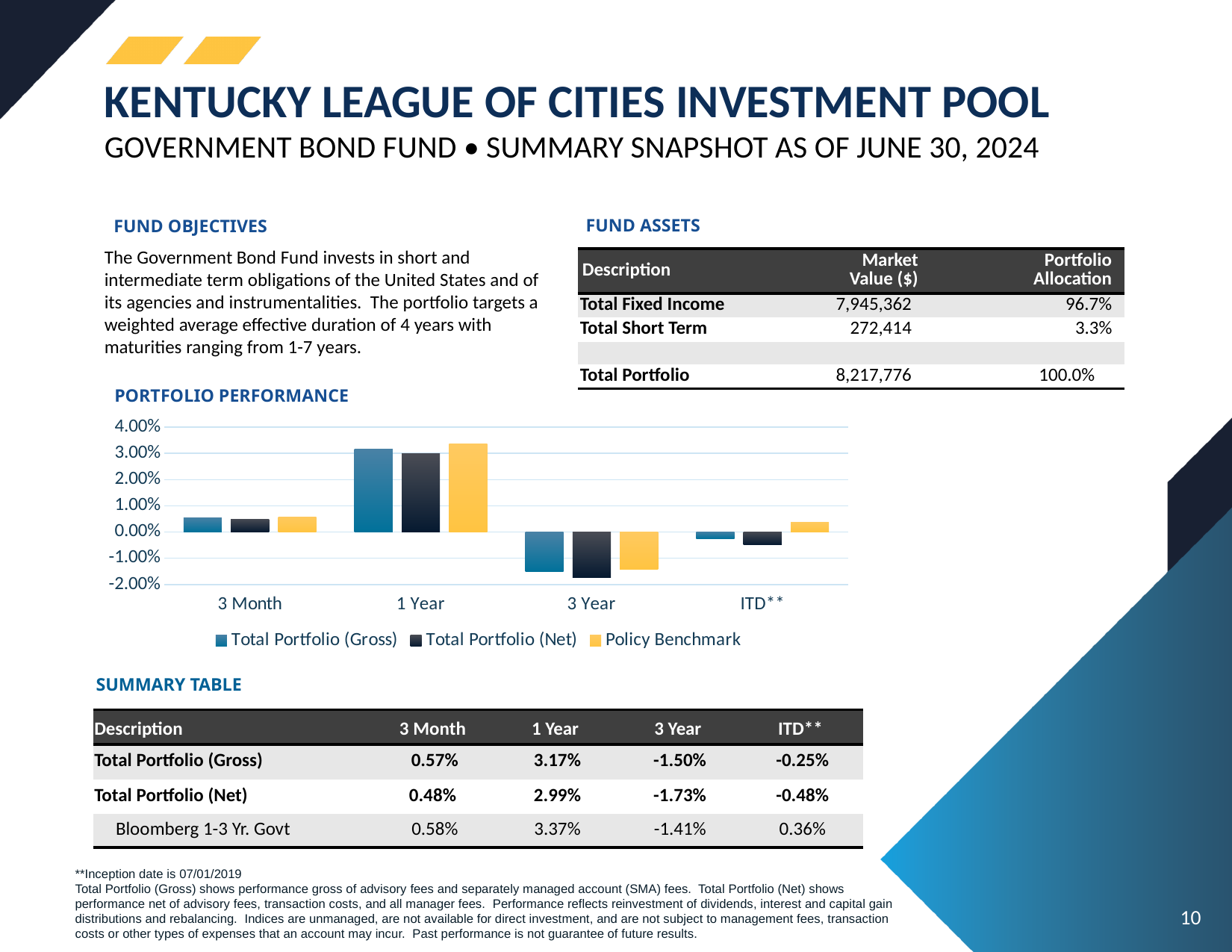
What kind of chart is shown under PORTFOLIO PERFORMANCE? Bar chart In the PORTFOLIO PERFORMANCE chart, which period has the lowest Total Portfolio (Net) value? 3 Year For the 1 Year period, which is larger: Total Portfolio (Gross) or Total Portfolio (Net)? Total Portfolio (Gross) What are the three legend entries of the PORTFOLIO PERFORMANCE chart? Total Portfolio (Gross), Total Portfolio (Net), Policy Benchmark What is the 1 Year value for Total Portfolio (Gross)? 3.17% What is the 3 Year value for Total Portfolio (Net)? -1.73% Is the Policy Benchmark value for 1 Year greater or less than 3.00%? greater Is the Policy Benchmark value for 3 Year greater or less than -1.00%? less How many series does the legend of the PORTFOLIO PERFORMANCE chart list? 3 What is the difference between Total Portfolio (Gross) and Total Portfolio (Net) for the 3 Month period? 0.09% In the PORTFOLIO PERFORMANCE chart, which period has the highest Total Portfolio (Gross) value? 1 Year How many time periods are shown on the x axis of the PORTFOLIO PERFORMANCE chart? 4